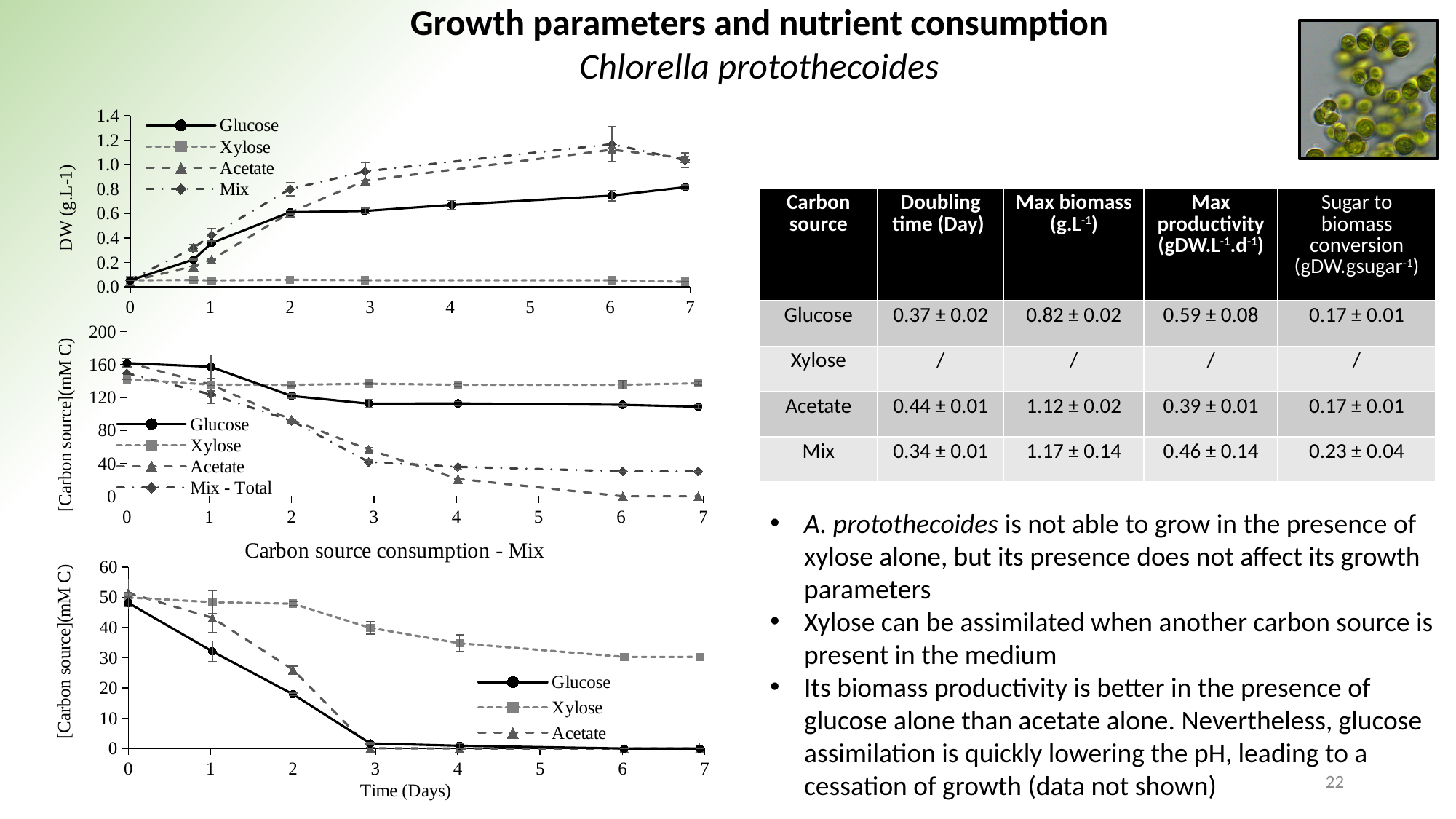
In the top chart (DW), which series is higher at day 7, Mix or Glucose? Mix In the middle chart ([Carbon source] mM C), is the Glucose value at day 7 greater or less than 80? greater In the top chart (DW), does the Glucose series rise or fall from day 0 to day 7? rise In the top chart (DW), is the Xylose value at day 7 greater or less than 0.2? less What is the title of the bottom chart? Carbon source consumption - Mix In the top chart (DW), is the Glucose value at day 7 greater or less than 0.6? greater How many series does the legend of the middle chart ([Carbon source] mM C) list? 4 In the bottom chart (Carbon source consumption - Mix), which series is higher at day 7, Xylose or Glucose? Xylose How many series does the legend of the top chart (DW) list? 4 In the middle chart ([Carbon source] mM C), does the Acetate series rise or fall over time? fall What kind of chart is the top chart showing DW (g.L-1) over time? line chart